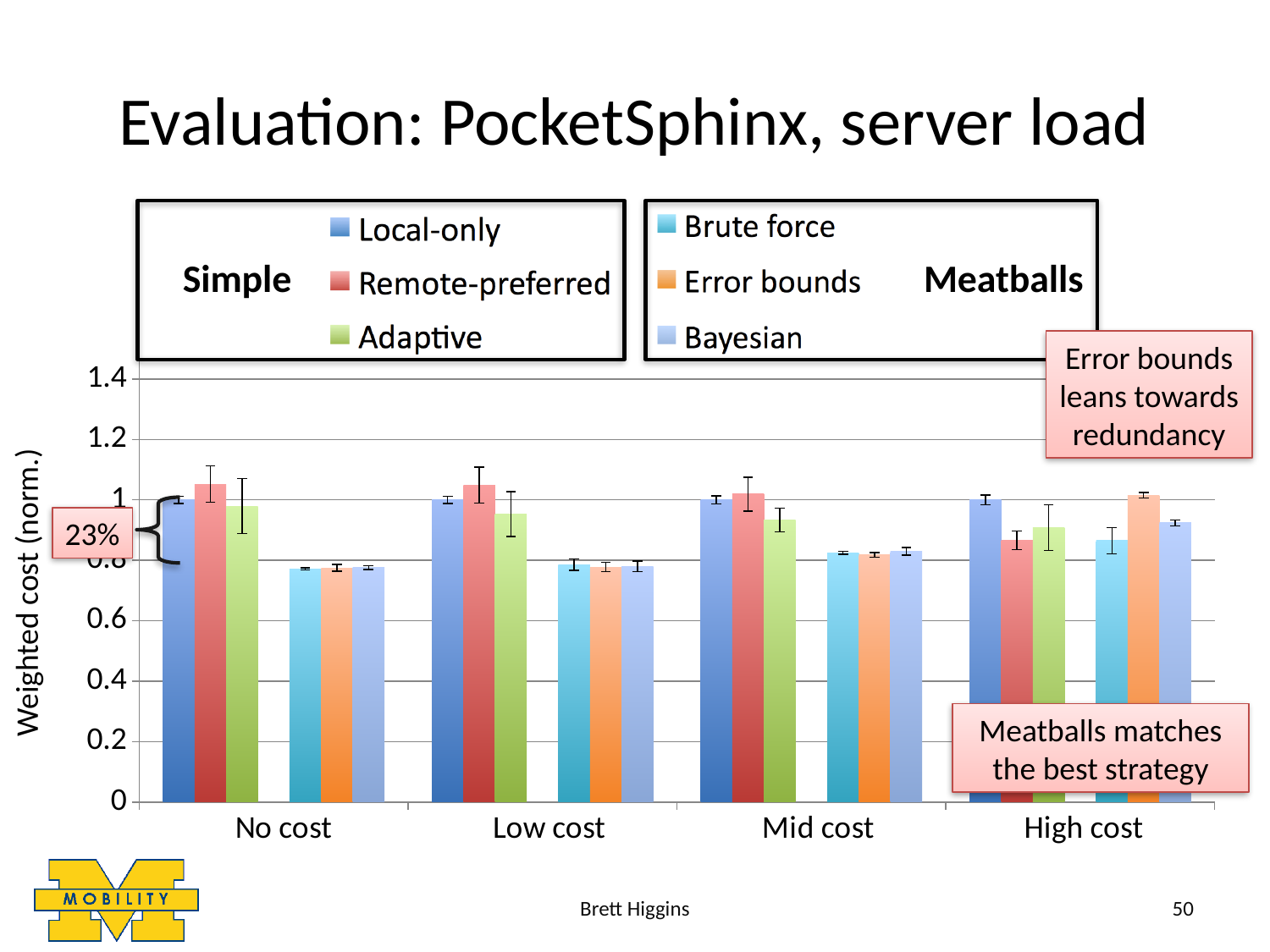
For Error bounds, which is larger: the value at Mid cost or the value at High cost? High cost What is the y-axis label of the chart? Weighted cost (norm.) At No cost, which is larger: Remote-preferred or Brute force? Remote-preferred How many series do the legends list in total? 6 Which three series are grouped under the 'Meatballs' legend? Brute force, Error bounds, Bayesian What kind of chart is shown on the slide? bar chart Do the Brute force values rise or fall from No cost to High cost? rise Is the value for Brute force at High cost greater or less than 0.8? greater Is the value for Remote-preferred at No cost greater or less than 1? greater Is the value for Adaptive at Mid cost greater or less than 1? less How many cost categories are shown on the x axis? 4